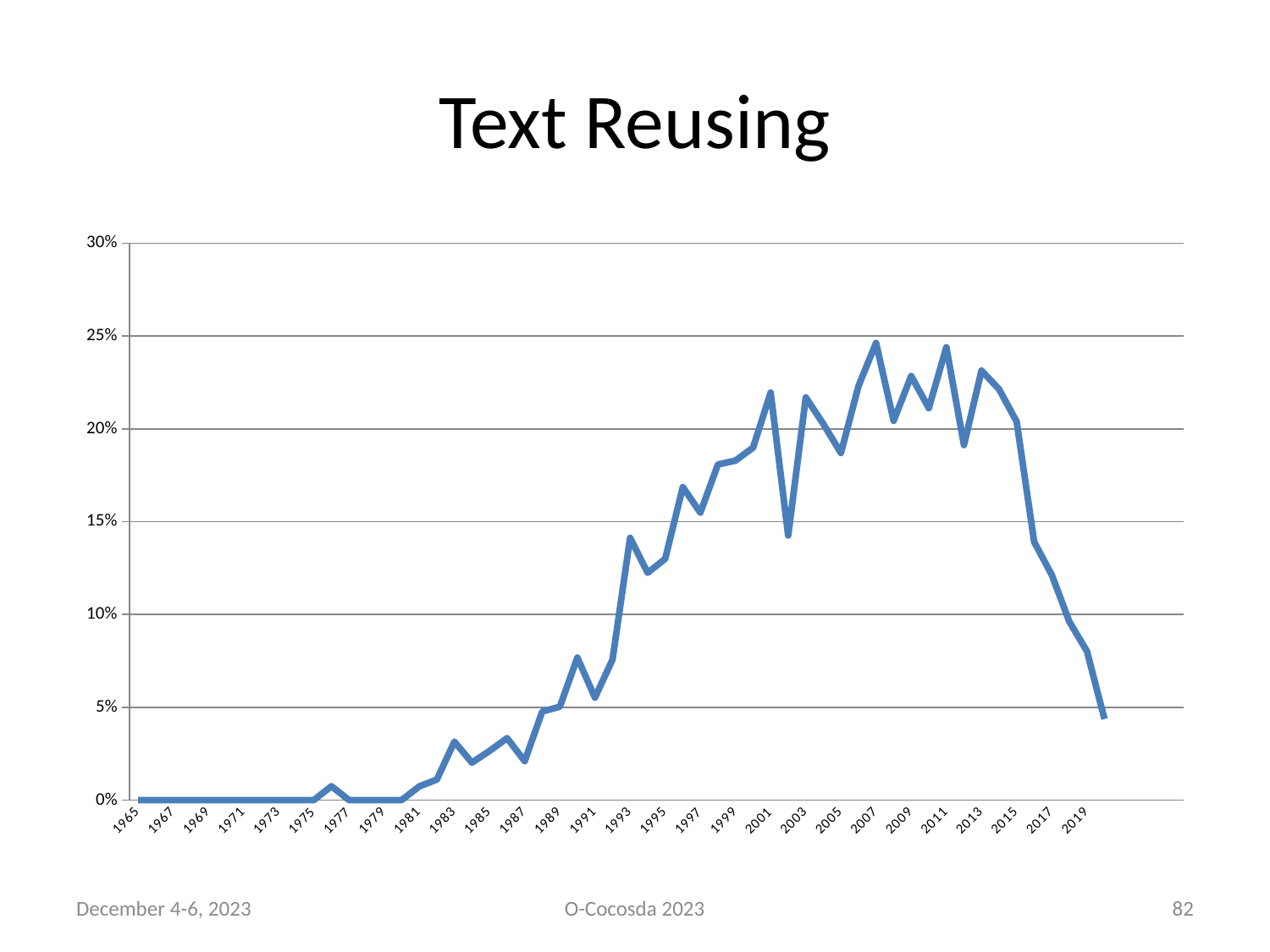
Is the value for 2002 greater or less than 15%? less Is the value for 1983 greater or less than 5%? less What is the highest value shown on the vertical axis? 30% What is the title of the chart? Text Reusing What is the value for 1970? 0% Does the line generally rise or fall between 1965 and 2007? rise Is the value for 2019 greater or less than 10%? less What kind of chart is shown on the slide? line chart What is the value for 1965? 0% Does the line generally rise or fall between 2013 and the last year shown? fall